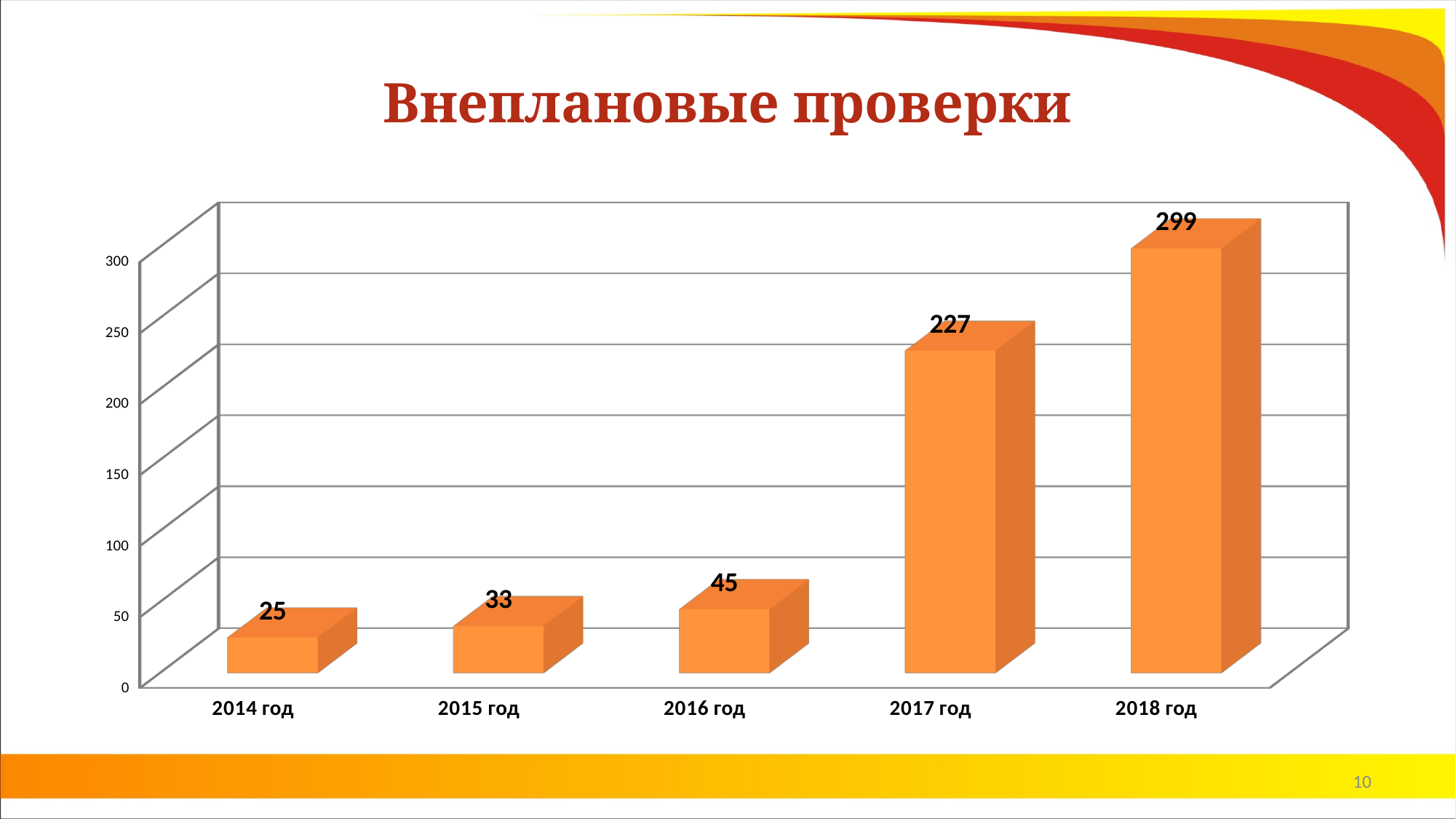
What kind of chart is shown on the slide? bar chart What is the difference between the values for 2018 год and 2017 год? 72 Is the value for 2017 год greater or less than 200? greater Do the values rise or fall from 2014 год to 2018 год? rise What is the value for 2014 год? 25 How many years are shown on the x axis? 5 Which year has the lowest value? 2014 год What is the difference between the values for 2016 год and 2015 год? 12 Which year has the highest value? 2018 год What is the value for 2018 год? 299 What is the value for 2016 год? 45 Which is larger, the value for 2015 год or the value for 2016 год? 2016 год